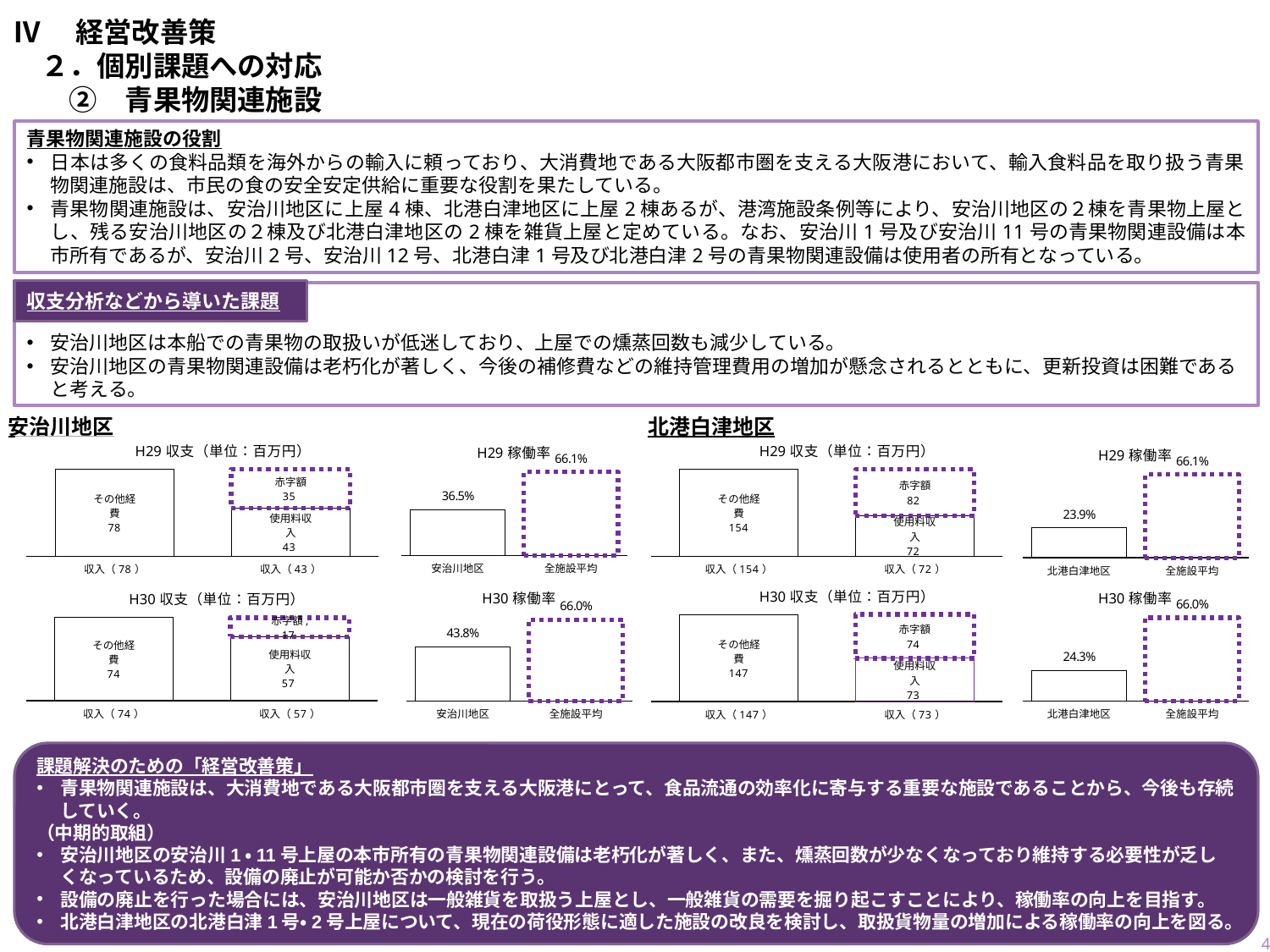
In the 安治川地区 H30 収支 chart, what is the total of the stacked bar made up of 赤字額 and 使用料収入? 74 In the 北港白津地区 H30 稼働率 chart, which category is lowest? 北港白津地区 In the 北港白津地区 H29 稼働率 chart, what is the value for 北港白津地区? 23.9% In the 北港白津地区 H29 収支 chart, which is larger, 赤字額 or 使用料収入? 赤字額 In the 安治川地区 H30 稼働率 chart, what is the difference between 全施設平均 and 安治川地区? 22.2% In the 北港白津地区 H30 収支 chart, what is the difference between 赤字額 and 使用料収入? 1 In the 安治川地区 H29 収支 chart, what is the value of 使用料収入? 43 In the 安治川地区 H29 稼働率 chart, what is the value for 安治川地区? 36.5% In the 安治川地区 H29 収支 chart, what is the value of 赤字額? 35 In the 北港白津地区 H29 収支 chart, what is the value of その他経費? 154 How many categories are shown on the x axis of the 北港白津地区 H29 稼働率 chart? 2 What kind of chart is the 安治川地区 H30 稼働率 chart? bar chart